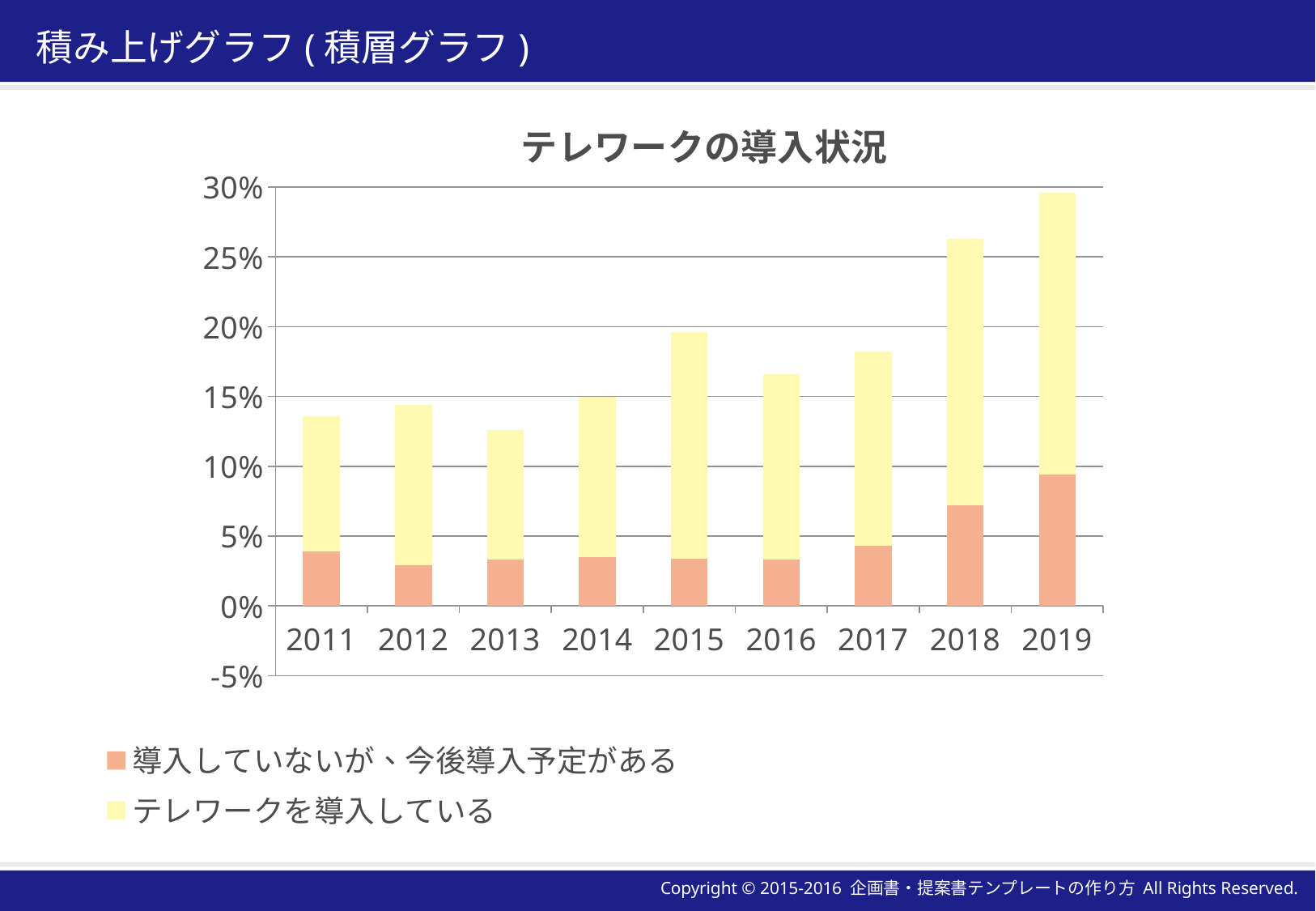
Is the total stacked value for 2019 greater or less than 25%? greater How many years are shown on the x axis of the chart? 9 What kind of chart is shown on the slide? Stacked bar chart Which year has the shortest stacked bar overall? 2013 What is the title of the chart? テレワークの導入状況 Which year has the largest 導入していないが、今後導入予定がある segment? 2019 Which year has the tallest stacked bar overall? 2019 Is the total stacked value for 2013 greater or less than 15%? less How many series does the legend list? 2 Which year has the larger total stacked bar, 2017 or 2018? 2018 Is the 導入していないが、今後導入予定がある value for 2019 greater or less than 5%? greater Which series does the orange colour represent in the legend? 導入していないが、今後導入予定がある